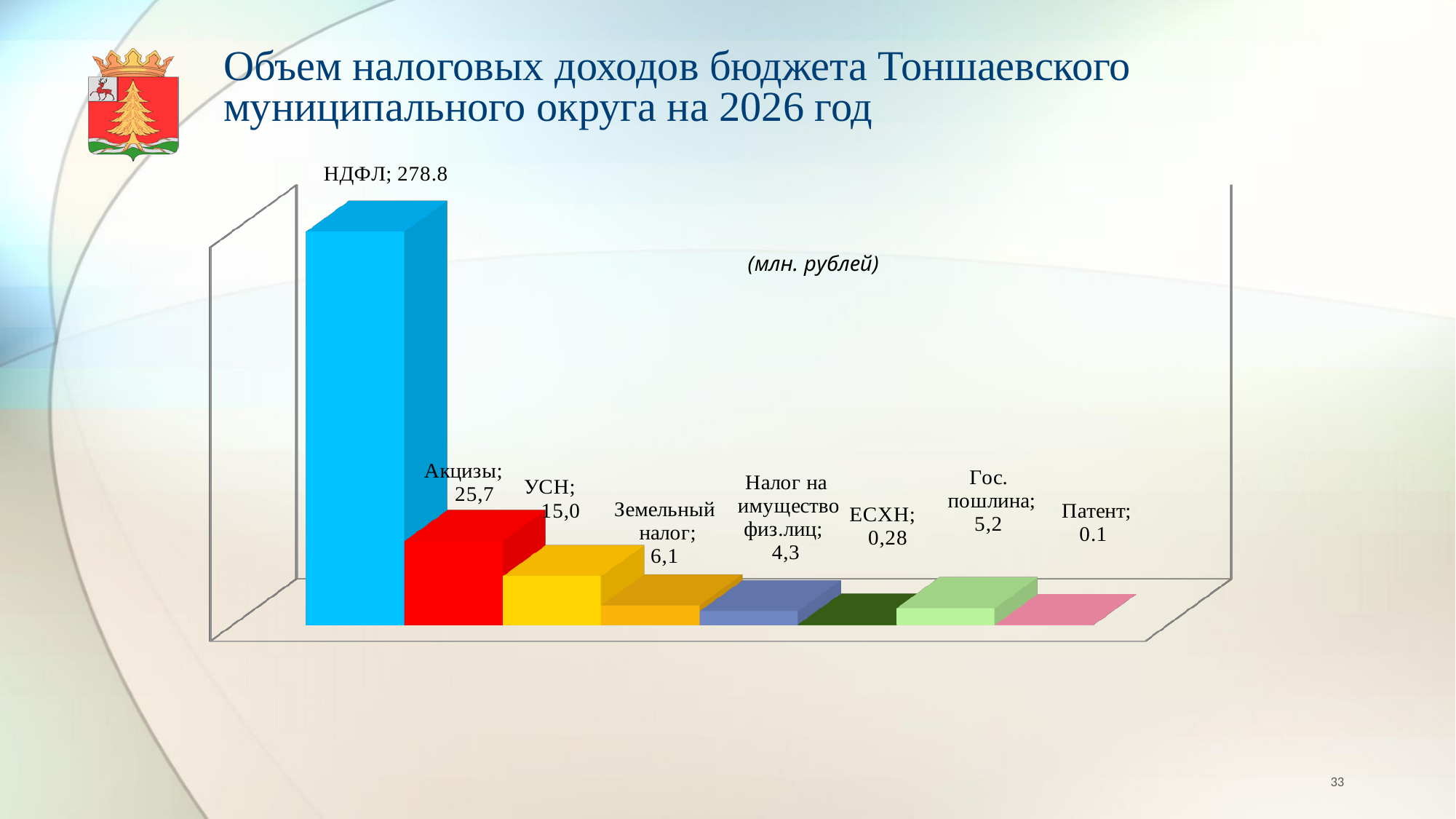
Which is larger: the value for Гос. пошлина or the value for Налог на имущество физ.лиц? Гос. пошлина What is the value for Земельный налог? 6,1 What is the value for Гос. пошлина? 5,2 Which category has the highest value? НДФЛ What is the value for Акцизы? 25,7 How many categories are shown in the chart? 8 What is the value for ЕСХН? 0,28 Which category has the lowest value? Патент What kind of chart is shown on the slide? Bar chart What is the value for УСН? 15,0 What is the value for НДФЛ? 278.8 What is the difference between the values for Акцизы and УСН? 10,7